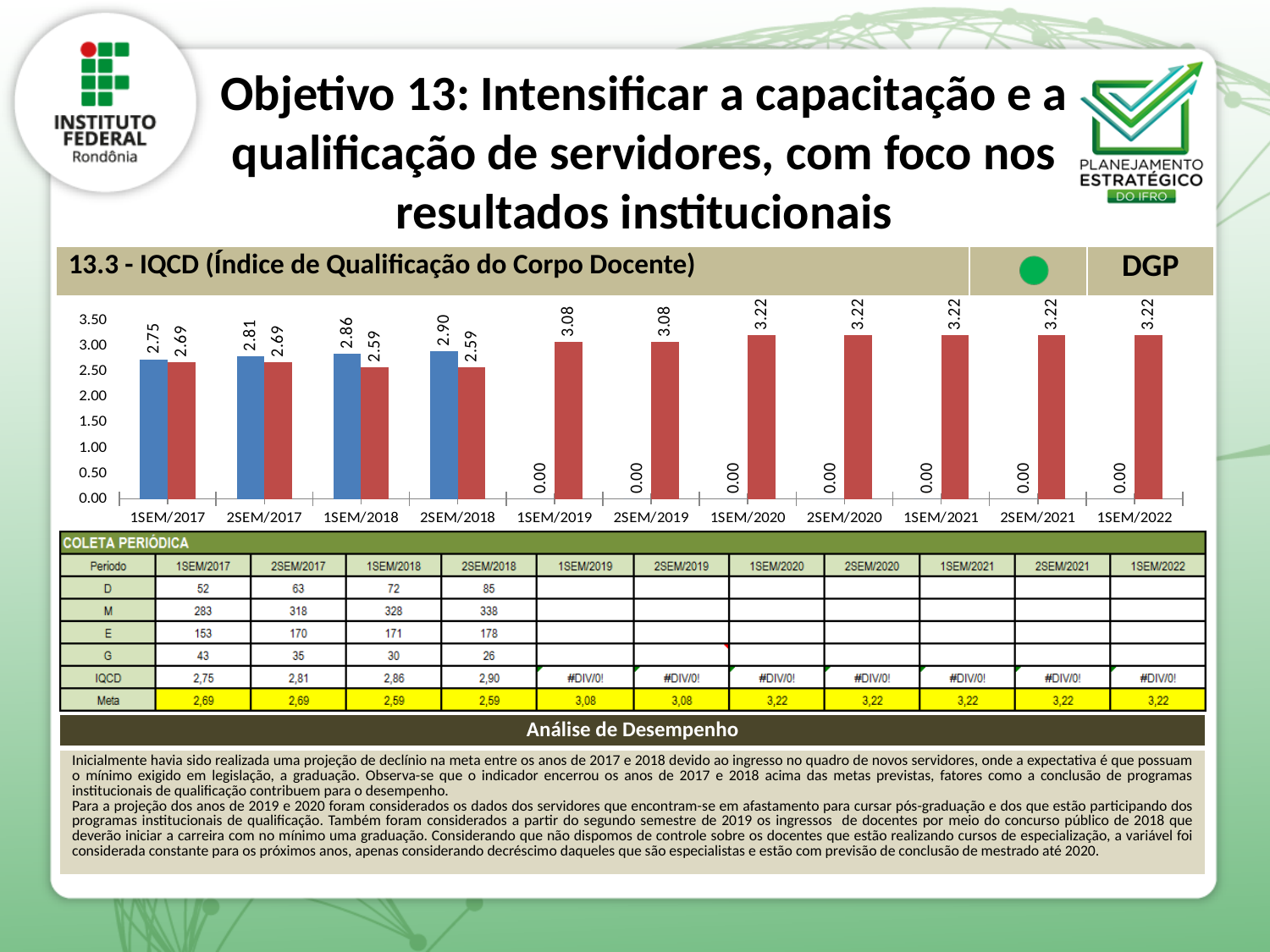
What is the title of the indicator shown above the chart? 13.3 - IQCD (Índice de Qualificação do Corpo Docente) Which period has the highest blue bar? 2SEM/2018 Do the blue bars rise or fall from 1SEM/2017 to 2SEM/2018? rise For 1SEM/2017, which is larger, the blue bar or the red bar? the blue bar What is the value of the red bar for 1SEM/2019? 3.08 What is the difference between the red bar for 1SEM/2020 and the red bar for 1SEM/2019? 0.14 What is the value of the blue bar for 1SEM/2018? 2.86 How many periods are shown on the x axis of the chart? 11 What kind of chart is shown on the slide? bar chart What is the difference between the blue bar and the red bar for 2SEM/2018? 0.31 What is the value of the blue bar for 1SEM/2019? 0.00 What is the value of the red bar for 2SEM/2018? 2.59